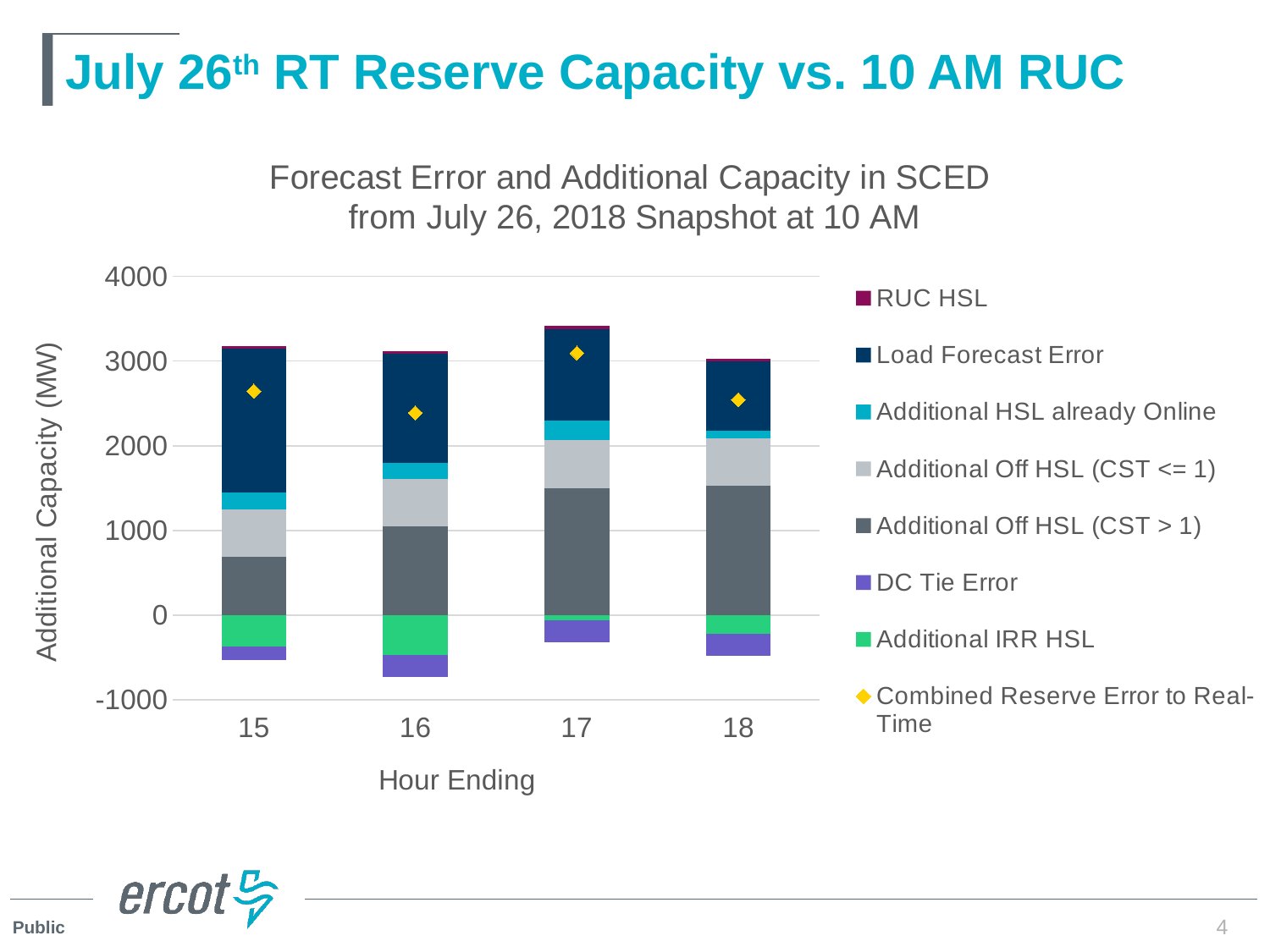
What is the title of the chart? Forecast Error and Additional Capacity in SCED from July 26, 2018 Snapshot at 10 AM Which hour ending has the tallest positive stacked bar? 17 Which hour ending has the smallest Additional Off HSL (CST > 1) segment? 15 Which hour ending has the bar extending furthest below zero? 16 How many hour-ending categories are shown on the x axis? 4 Is the Combined Reserve Error to Real-Time value for hour ending 17 greater or less than 3000? greater How many series does the legend list? 8 Which hour ending has the highest Combined Reserve Error to Real-Time marker? 17 Is the Combined Reserve Error to Real-Time value for hour ending 16 greater or less than 3000? less Is the Combined Reserve Error to Real-Time value for hour ending 15 greater or less than 2000? greater What is the label of the y axis? Additional Capacity (MW) What kind of chart is shown on the slide? Stacked bar chart